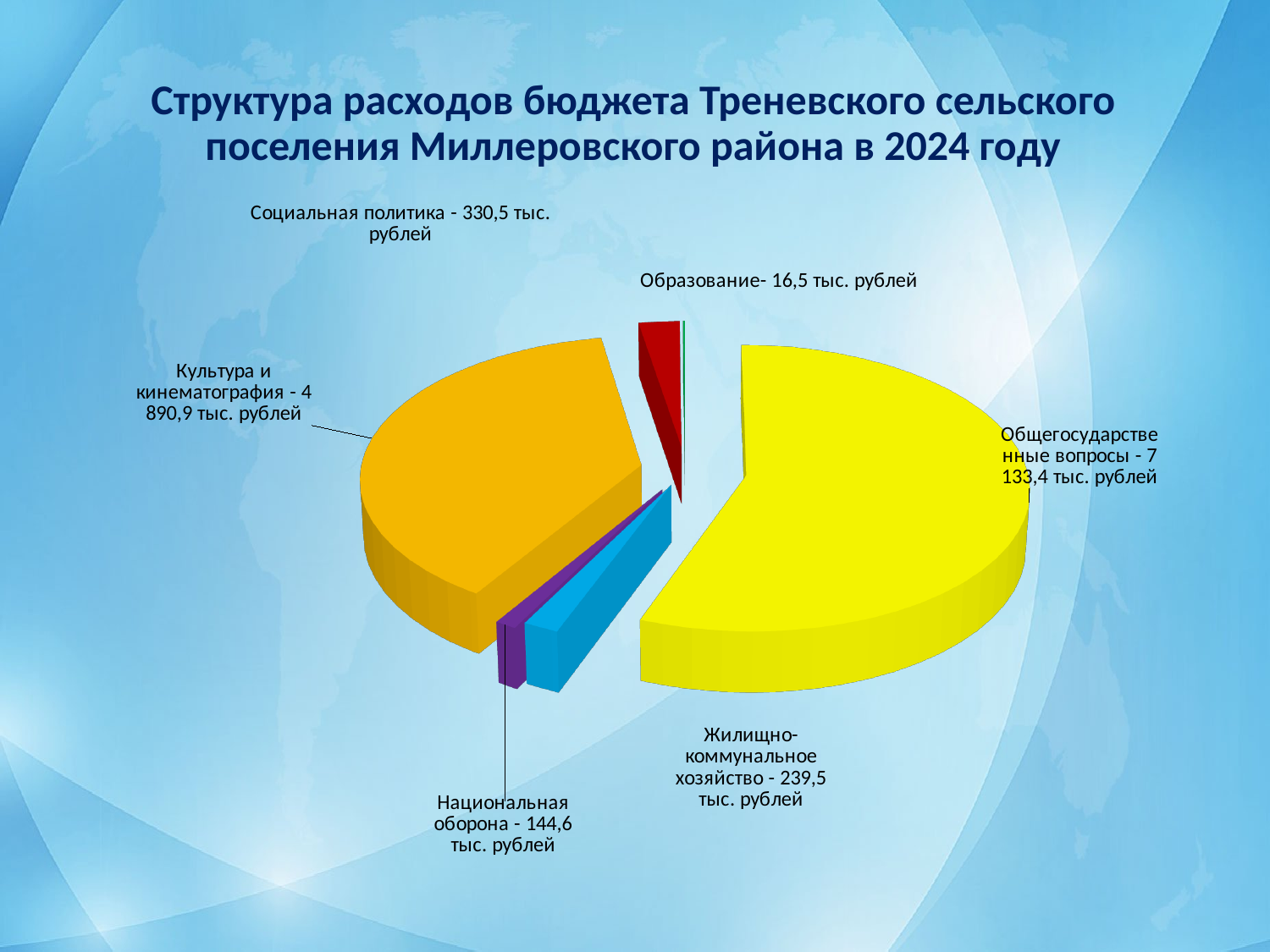
Which category has the largest value? Общегосударственные вопросы Which is larger, Жилищно-коммунальное хозяйство or Национальная оборона? Жилищно-коммунальное хозяйство How many categories does the pie chart show? 6 What is the value for Общегосударственные вопросы? 7 133,4 тыс. рублей What is the value for Социальная политика? 330,5 тыс. рублей What kind of chart is shown on the slide? Pie chart What is the difference between Общегосударственные вопросы and Культура и кинематография? 2 242,5 тыс. рублей Which category has the smallest value? Образование What is the difference between Социальная политика and Жилищно-коммунальное хозяйство? 91,0 тыс. рублей What is the value for Культура и кинематография? 4 890,9 тыс. рублей What is the value for Национальная оборона? 144,6 тыс. рублей What year does the chart title refer to? 2024